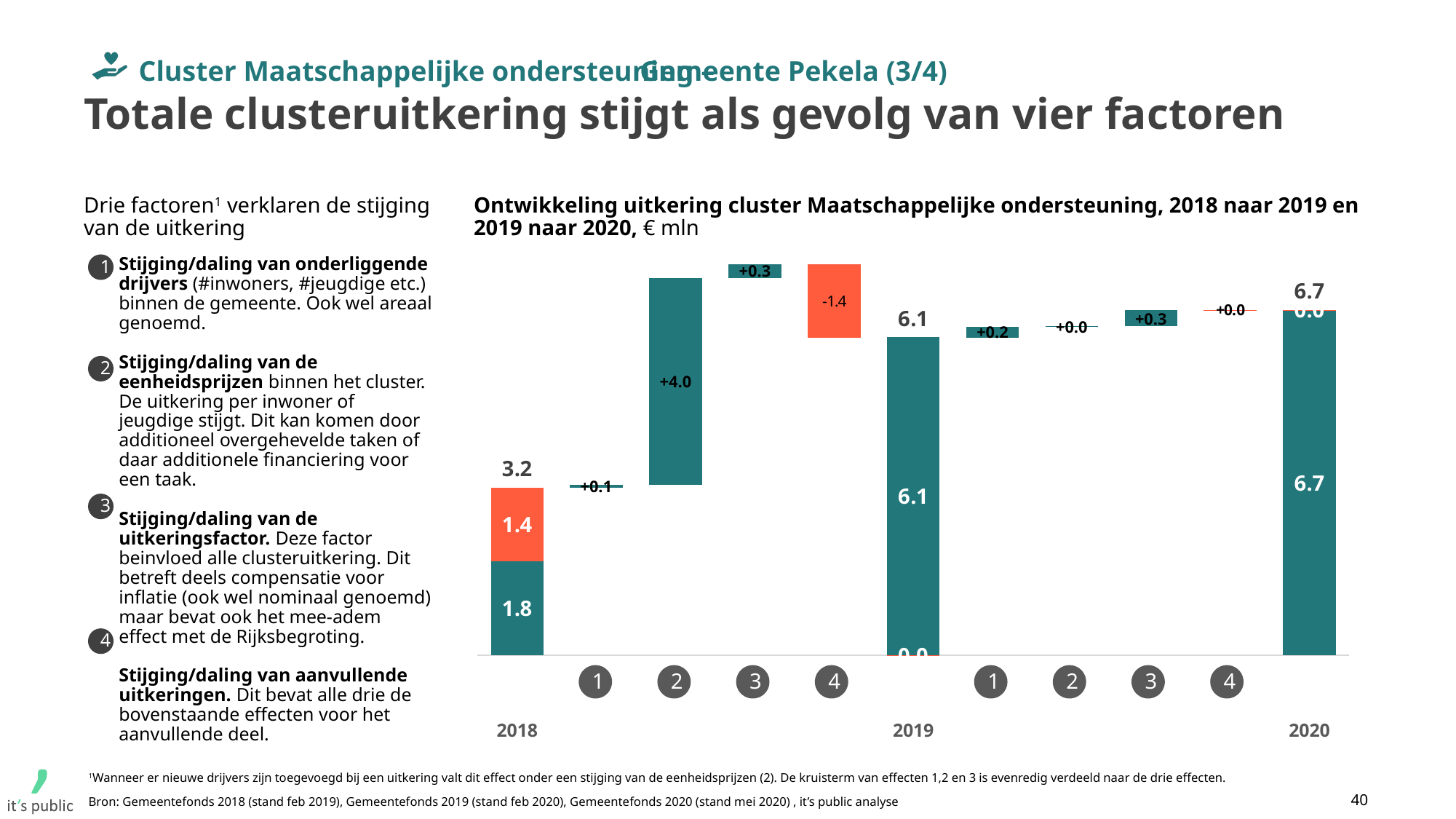
What is the value of factor 1 in the step from 2019 to 2020? +0.2 What is the total cluster payment shown for 2019? 6.1 What is the value of factor 2 (eenheidsprijzen) in the step from 2018 to 2019? +4.0 What are the two components of the 2018 bar, as labelled? 1.8 and 1.4 By how much does the total cluster payment increase from 2019 to 2020? 0.6 What is the total cluster payment shown for 2018? 3.2 In what unit are the values in the chart expressed? € mln Is the total for 2020 larger or smaller than the total for 2018? Larger What is the value of factor 4 (aanvullende uitkeringen) in the step from 2018 to 2019? -1.4 What is the value of factor 3 in the step from 2019 to 2020? +0.3 Which of the four factors between 2018 and 2019 has the largest positive effect? Factor 2 (+4.0) What is the total cluster payment shown for 2020? 6.7